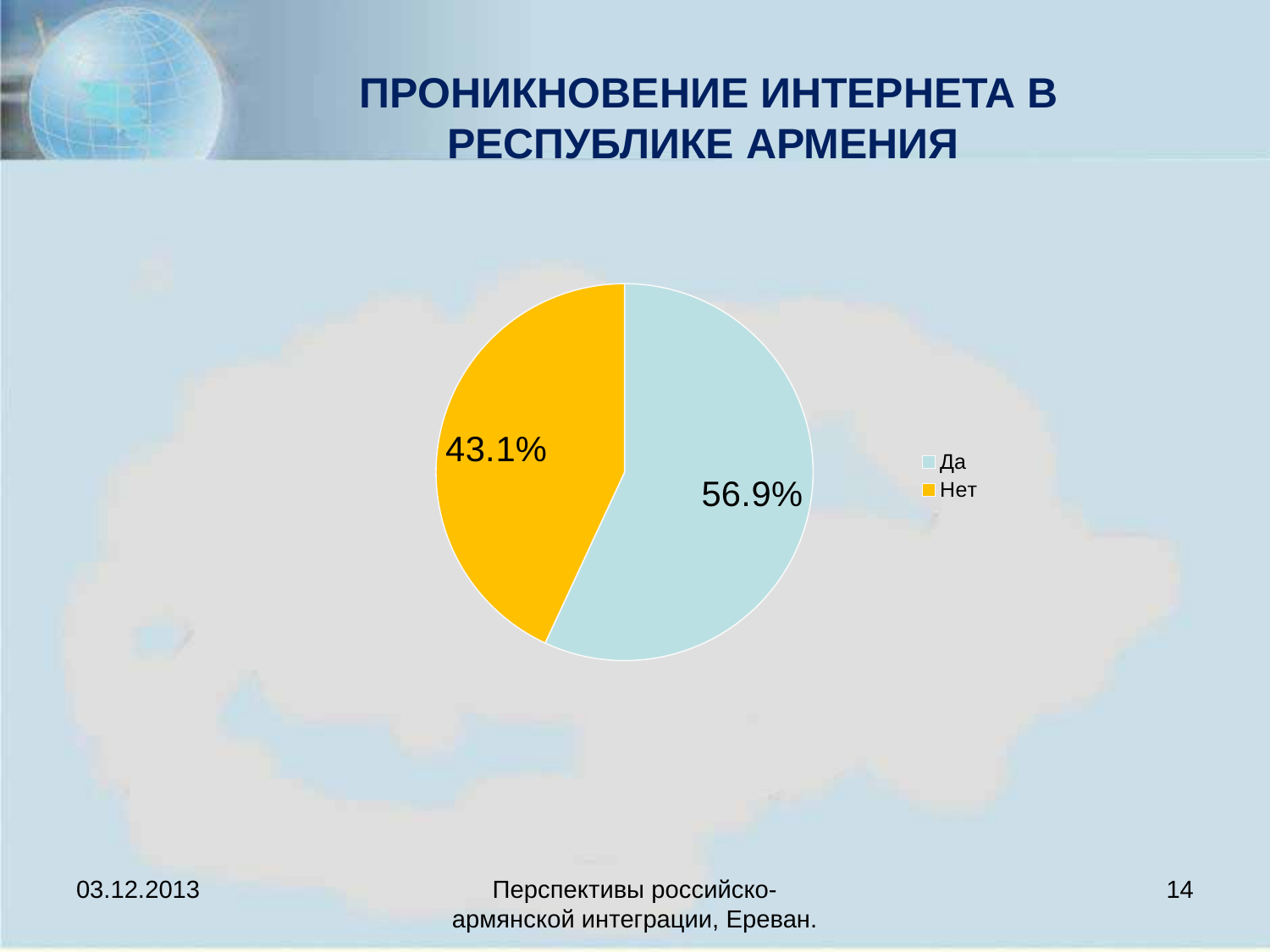
What is the value for the "Да" slice? 56.9% What kind of chart is shown on the slide? pie chart Which is larger, the "Да" slice or the "Нет" slice? Да What is the difference between the "Да" and "Нет" slices? 13.8% What share of the pie does the "Нет" slice represent? 43.1% How many entries does the legend list? 2 What colour is the "Нет" slice? orange How many slices does the pie chart have? 2 What is the title of the slide containing the chart? ПРОНИКНОВЕНИЕ ИНТЕРНЕТА В РЕСПУБЛИКЕ АРМЕНИЯ Which slice is the smallest? Нет Which slice is the largest? Да What is the value for the "Нет" slice? 43.1%